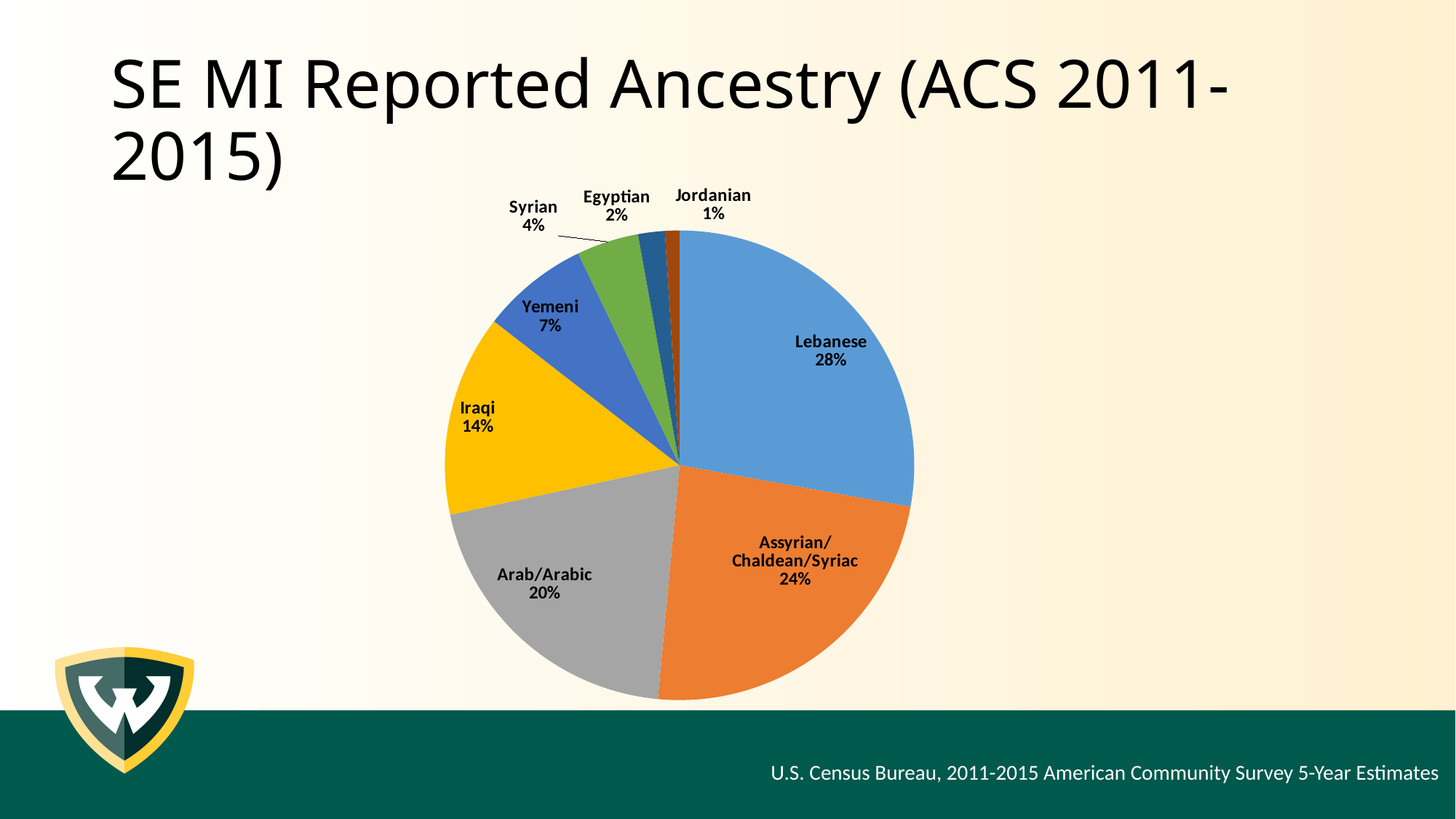
What percentage of the pie is the Lebanese slice? 28% What percentage is shown for Assyrian/Chaldean/Syriac? 24% What is the difference in percentage points between the Iraqi and Yemeni slices? 7 What type of chart is shown on the slide? pie chart Which ancestry has the largest share of the pie? Lebanese How many slices does the pie chart have? 8 What percentage is shown for Yemeni? 7% What is the title of the chart on the slide? SE MI Reported Ancestry (ACS 2011-2015) What is the difference in percentage points between the Lebanese and Arab/Arabic slices? 8 Which ancestry has the smallest share of the pie? Jordanian What percentage is shown for Iraqi? 14% Which is larger, the Syrian slice or the Egyptian slice? Syrian